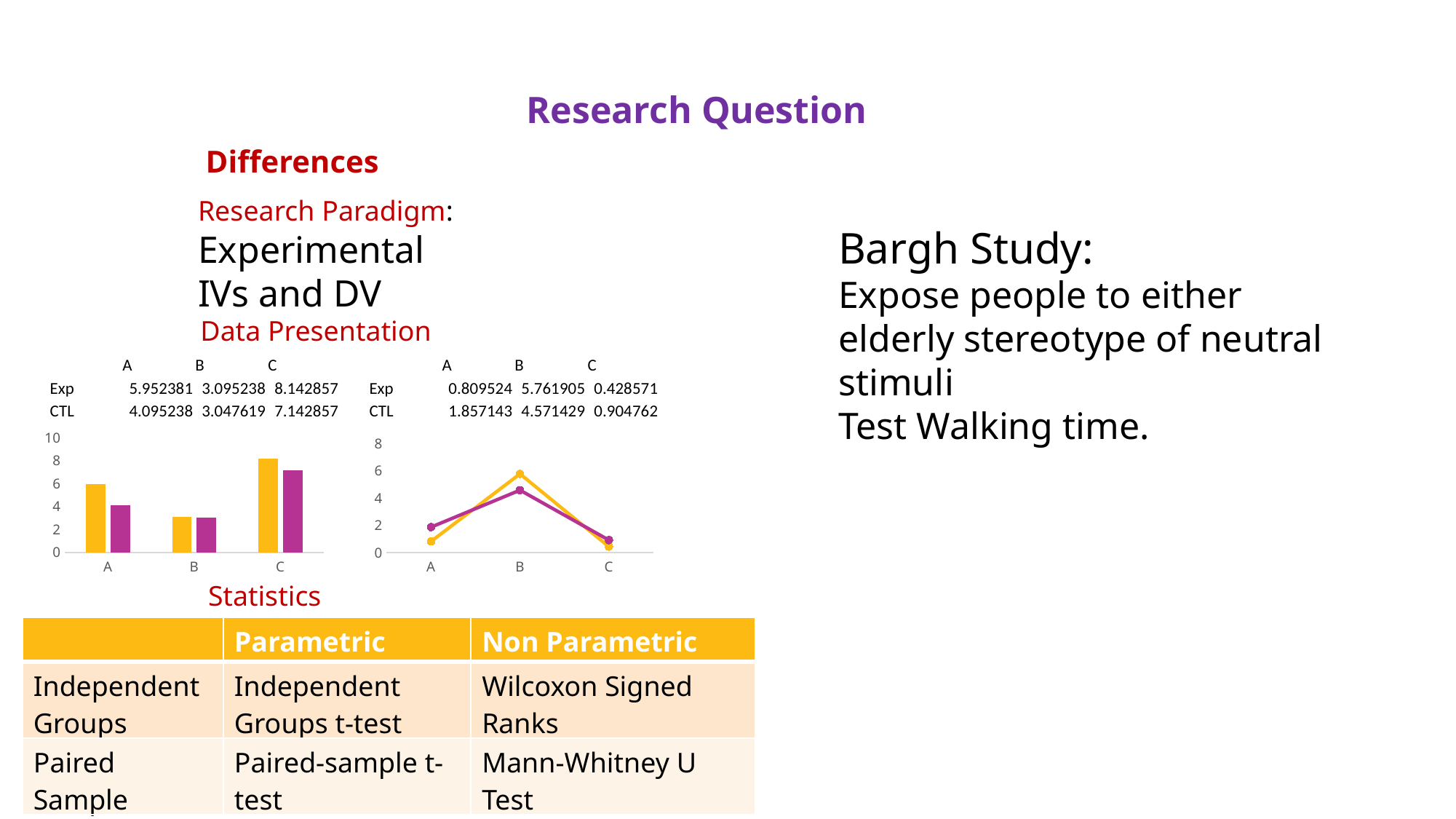
In the left bar chart, which is larger for category A, Exp or CTL? Exp In the left bar chart, which category has the highest Exp value? C In the right line chart, which is larger for category A, Exp or CTL? CTL In the right line chart, does the Exp line rise or fall from B to C? fall How many categories are shown on the x axis of the left bar chart? 3 In the right line chart, what is the CTL value for category B? 4.571429 In the left bar chart, what is the difference between the Exp and CTL values for category C? 1 In the right line chart, is the Exp value for B greater or less than 4? greater In the left bar chart, what is the Exp value for category C? 8.142857 What kind of chart is the left chart under Data Presentation? bar chart In the right line chart, which category has the lowest Exp value? C What kind of chart is the right chart under Data Presentation? line chart